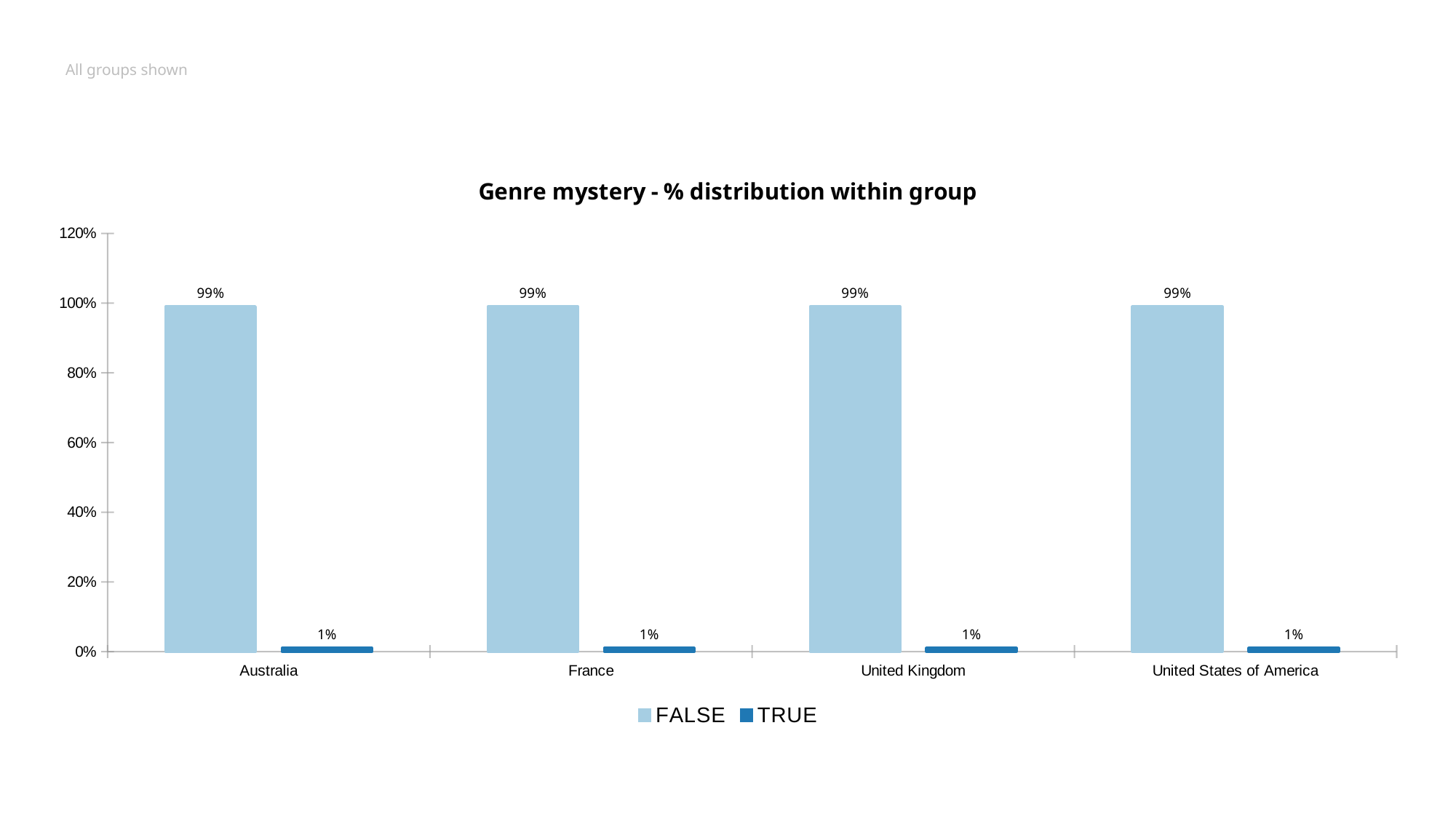
What kind of chart is shown? bar chart Is the FALSE value for United Kingdom greater or less than 80%? greater What is the FALSE value for Australia? 99% Which is larger for France, the FALSE value or the TRUE value? FALSE What is the difference between the FALSE and TRUE values for Australia? 98% How many series does the legend list? 2 What is the TRUE value for France? 1% What is the FALSE value for United Kingdom? 99% What is the title of the chart? Genre mystery - % distribution within group What is the TRUE value for United States of America? 1% How many categories are shown on the x axis? 4 Is the TRUE value for Australia greater or less than 20%? less